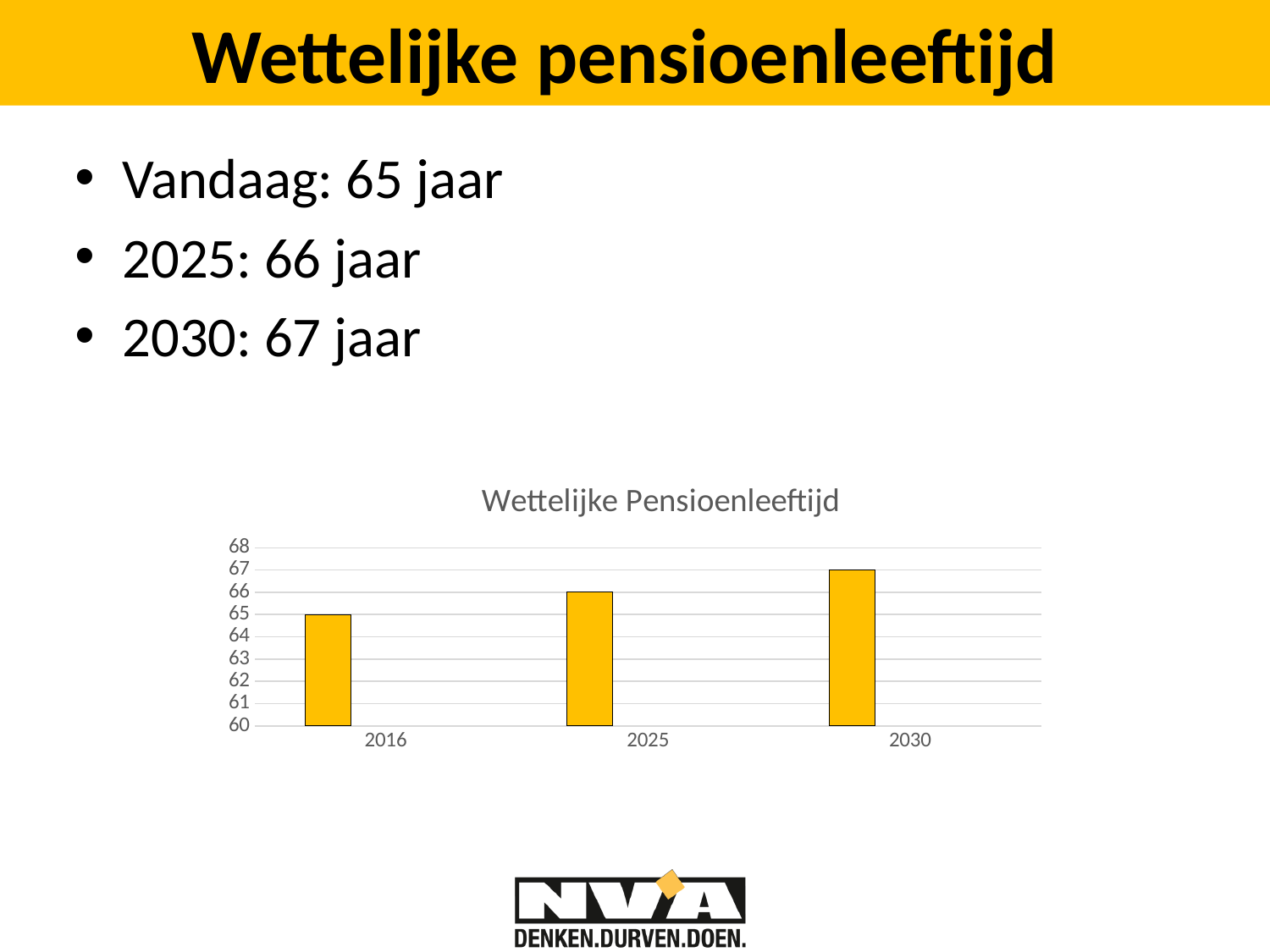
What is the title of the chart? Wettelijke Pensioenleeftijd What kind of chart is shown on the slide? bar chart What is the difference between the values for 2030 and 2016? 2 Which year has the highest value in the chart? 2030 Do the values rise or fall from 2016 to 2030? rise What is the value for 2016 in the chart? 65 What is the value for 2025 in the chart? 66 Which year has the lowest value in the chart? 2016 How many categories are shown on the x axis of the chart? 3 What is the value for 2030 in the chart? 67 Is the value for 2030 greater or less than 66? greater Which is larger, the value for 2025 or the value for 2016? 2025